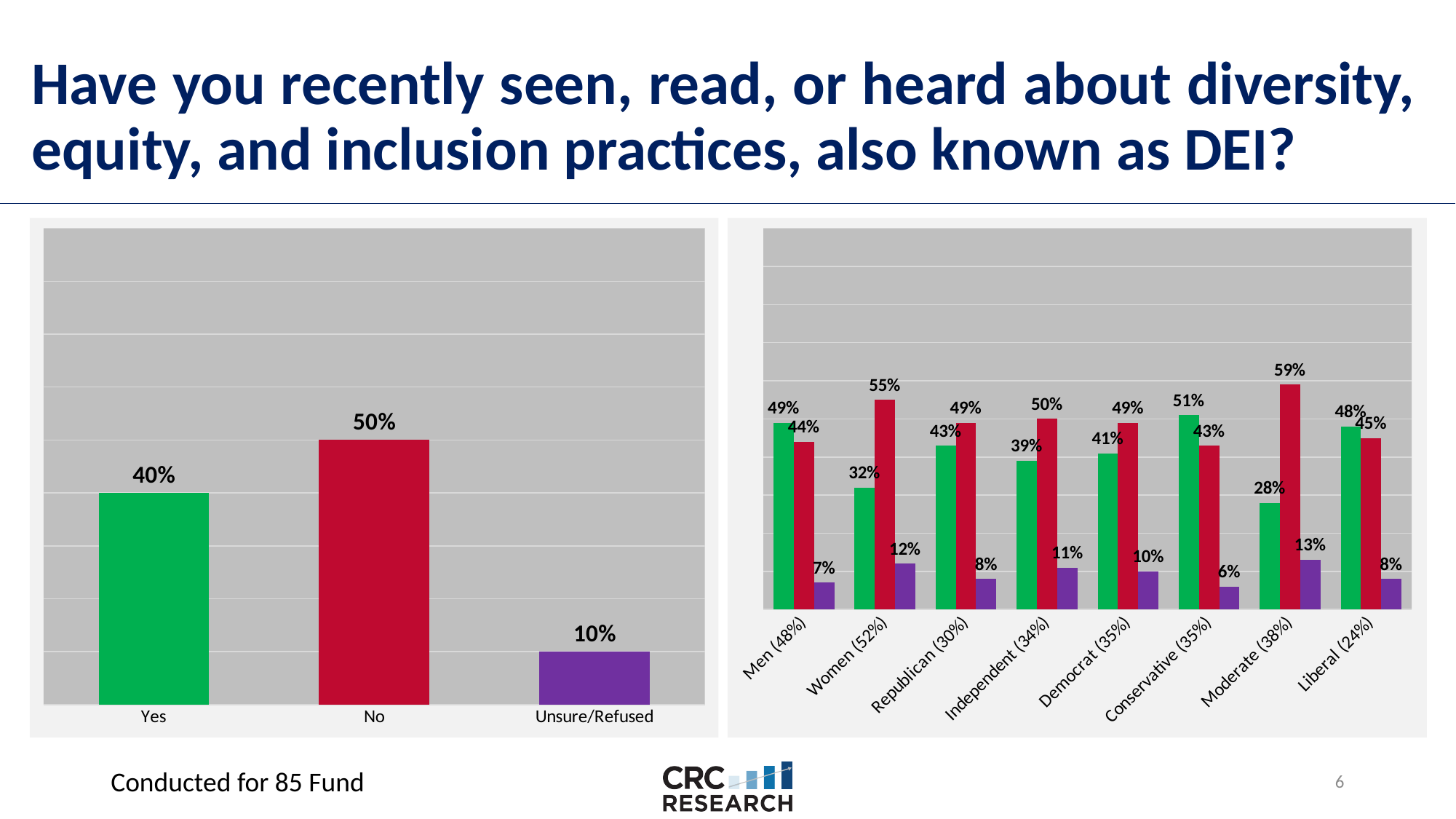
In the right chart, is the green bar or the red bar larger for Conservative (35%)? Green bar What type of chart is the left chart? Bar chart In the right chart, which group has the highest purple bar? Moderate (38%) In the right chart, which group has the lowest green bar? Moderate (38%) How many groups are shown on the x axis of the right chart? 8 In the left chart, which response has the highest value? No In the right chart, what is the value of the green bar for Women (52%)? 32% In the left chart, what is the difference between the No and Yes values? 10% In the left chart, what percentage of respondents answered Yes? 40% In the left chart, which response has the lowest value? Unsure/Refused How many categories are shown on the x axis of the left chart? 3 In the right chart, what is the value of the red bar for Moderate (38%)? 59%